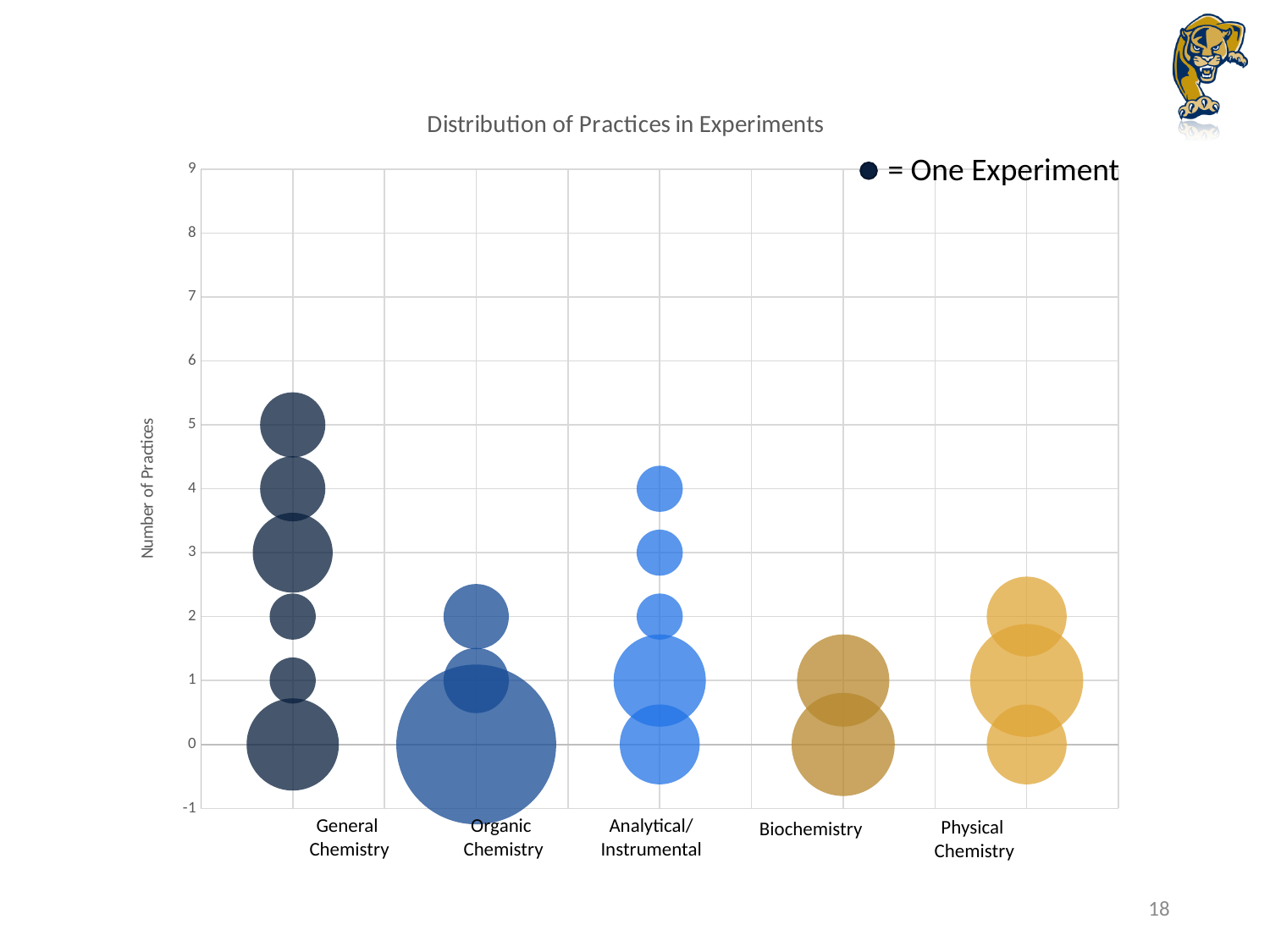
How many bubbles are plotted for General Chemistry? 6 Which category has a bubble at the highest number of practices? General Chemistry What kind of chart is shown on the slide? Bubble chart What is the highest number of practices at which Biochemistry has a bubble? 1 What is the label of the vertical axis? Number of Practices Is the highest bubble for Physical Chemistry greater or less than 3 practices? less How many categories are shown along the x axis? 5 Which category contains the largest single bubble? Organic Chemistry What is the highest number of practices at which Analytical/Instrumental has a bubble? 4 How many bubbles are plotted for Biochemistry? 2 What is the highest number of practices at which General Chemistry has a bubble? 5 What is the title of the chart? Distribution of Practices in Experiments